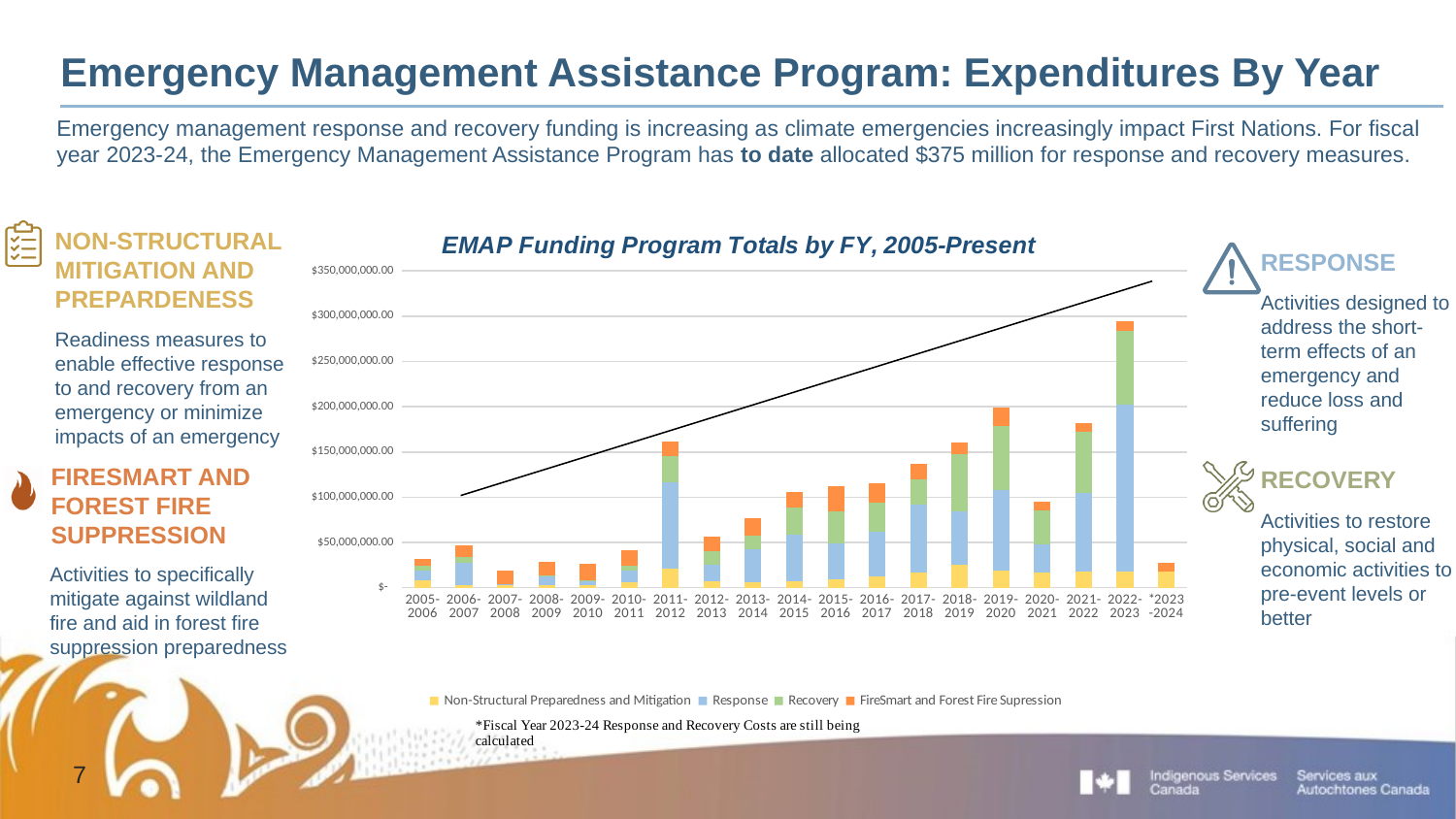
Is the total for 2007-2008 greater or less than $50,000,000.00? less Is the total for 2011-2012 greater or less than $100,000,000.00? greater Which has the larger total bar, 2011-2012 or 2012-2013? 2011-2012 Which fiscal year has the highest total bar? 2022-2023 How many series does the chart legend list? 4 Is the total for 2019-2020 greater or less than $150,000,000.00? greater How many fiscal-year categories are plotted along the x axis? 19 What kind of chart is shown on the slide? Stacked bar chart Which series is shown in blue in the legend? Response What is the title of the chart? EMAP Funding Program Totals by FY, 2005-Present Do the total expenditures generally rise or fall from 2005-2006 to 2022-2023? rise